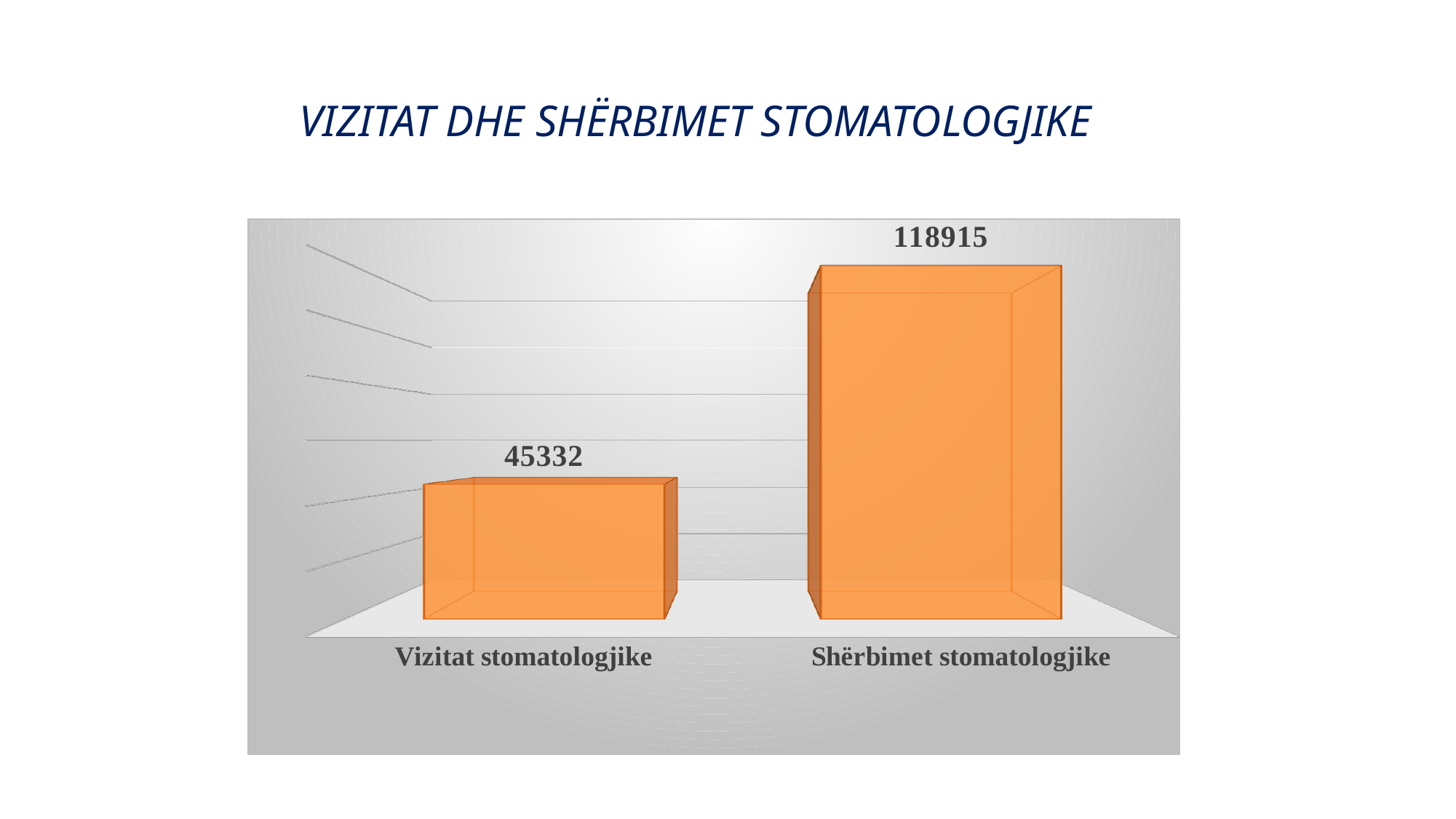
What colour are the bars in the chart? orange How many categories are shown in the chart? 2 Which category has the lowest value? Vizitat stomatologjike What is the value for Vizitat stomatologjike? 45332 Which category has the highest value? Shërbimet stomatologjike Which is larger, the value for Vizitat stomatologjike or the value for Shërbimet stomatologjike? Shërbimet stomatologjike What is the difference between the values for Shërbimet stomatologjike and Vizitat stomatologjike? 73583 What is the value for Shërbimet stomatologjike? 118915 What kind of chart is shown on the slide? bar chart What is the title of the slide? VIZITAT DHE SHËRBIMET STOMATOLOGJIKE What is the total of the two values shown in the chart? 164247